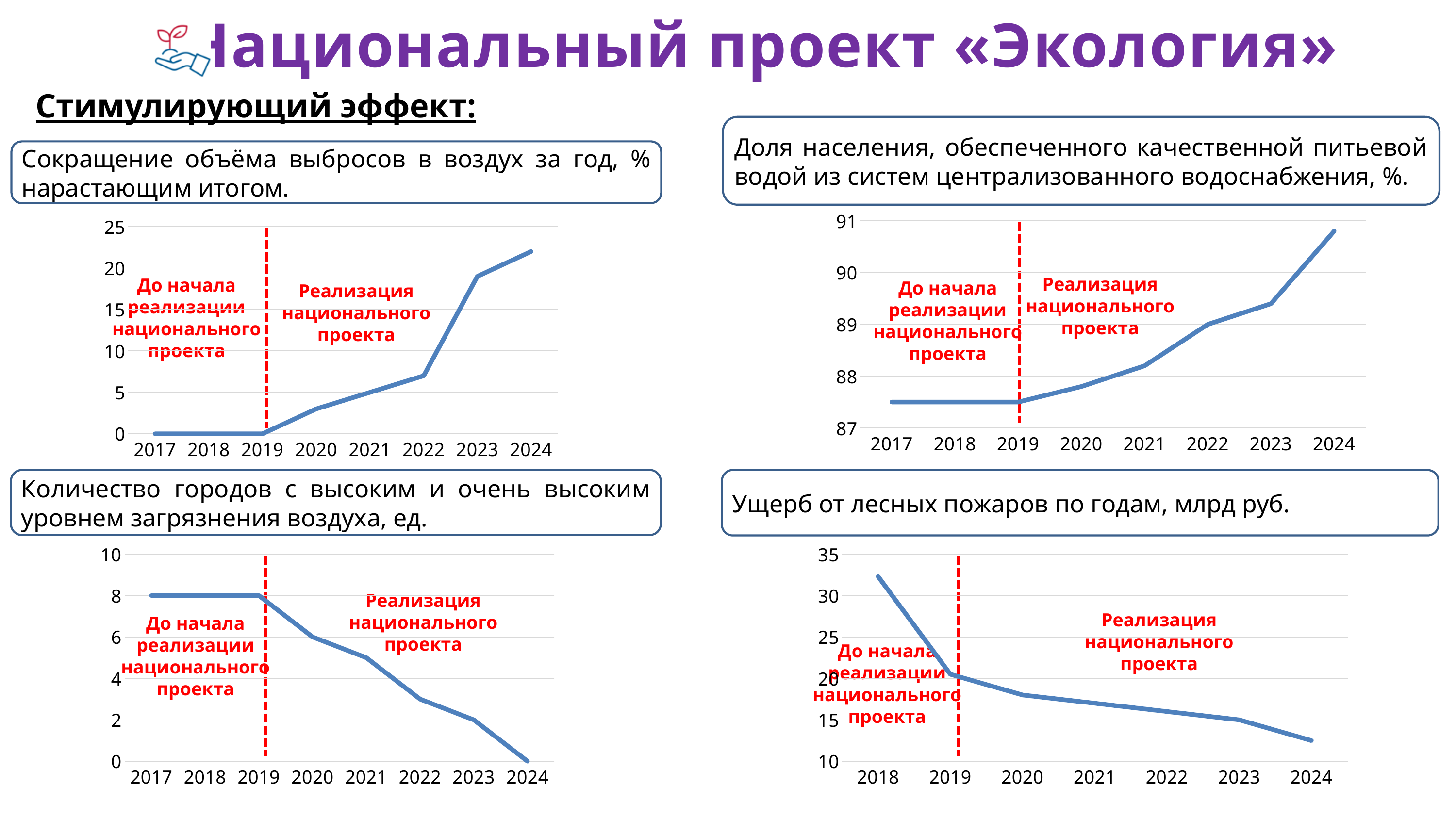
In the top-right chart (Доля населения, обеспеченного качественной питьевой водой), do the values rise or fall from 2019 to 2024? rise In the bottom-right chart (Ущерб от лесных пожаров по годам), how many years are shown on the x axis? 7 In the top-left chart (Сокращение объёма выбросов в воздух за год), what is the value for 2017? 0 What kind of chart is the top-left chart (Сокращение объёма выбросов в воздух за год)? line chart In the top-left chart (Сокращение объёма выбросов в воздух за год), is the value for 2024 greater or less than 20? greater In the top-right chart (Доля населения, обеспеченного качественной питьевой водой), is the value for 2024 greater or less than 90? greater In the top-left chart (Сокращение объёма выбросов в воздух за год), how many years are shown on the x axis? 8 In the bottom-left chart (Количество городов с высоким и очень высоким уровнем загрязнения воздуха), which is larger, the value for 2020 or the value for 2023? 2020 In the bottom-left chart (Количество городов с высоким и очень высоким уровнем загрязнения воздуха), what is the value for 2024? 0 In the bottom-left chart (Количество городов с высоким и очень высоким уровнем загрязнения воздуха), what is the value for 2017? 8 In the bottom-right chart (Ущерб от лесных пожаров по годам), is the value for 2018 greater or less than 30? greater In the top-left chart (Сокращение объёма выбросов в воздух за год), which year has the highest value? 2024